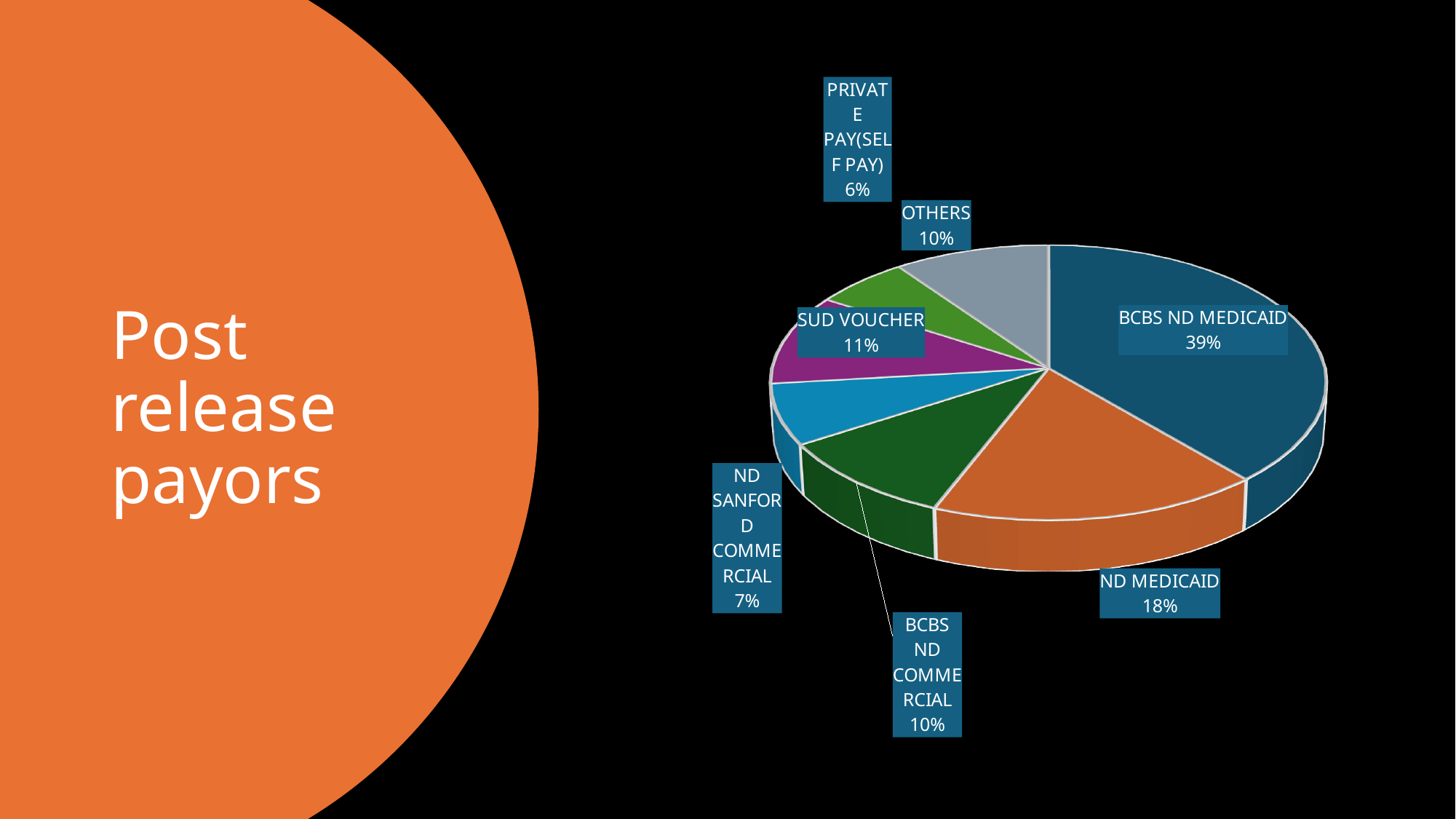
What is the title text on the left side of the slide? Post release payors What is the value shown for PRIVATE PAY(SELF PAY)? 6% What share of the pie does BCBS ND MEDICAID have? 39% Which is larger, the share for SUD VOUCHER or the share for ND SANFORD COMMERCIAL? SUD VOUCHER What share of the pie does ND MEDICAID have? 18% What is the value shown for SUD VOUCHER? 11% What is the difference in percentage points between BCBS ND MEDICAID and ND MEDICAID? 21 Which payor has the smallest slice of the pie? PRIVATE PAY(SELF PAY) How many slices does the pie chart have? 7 Which payor has the largest slice of the pie? BCBS ND MEDICAID What kind of chart is shown on the slide? Pie chart What is the value shown for ND SANFORD COMMERCIAL? 7%